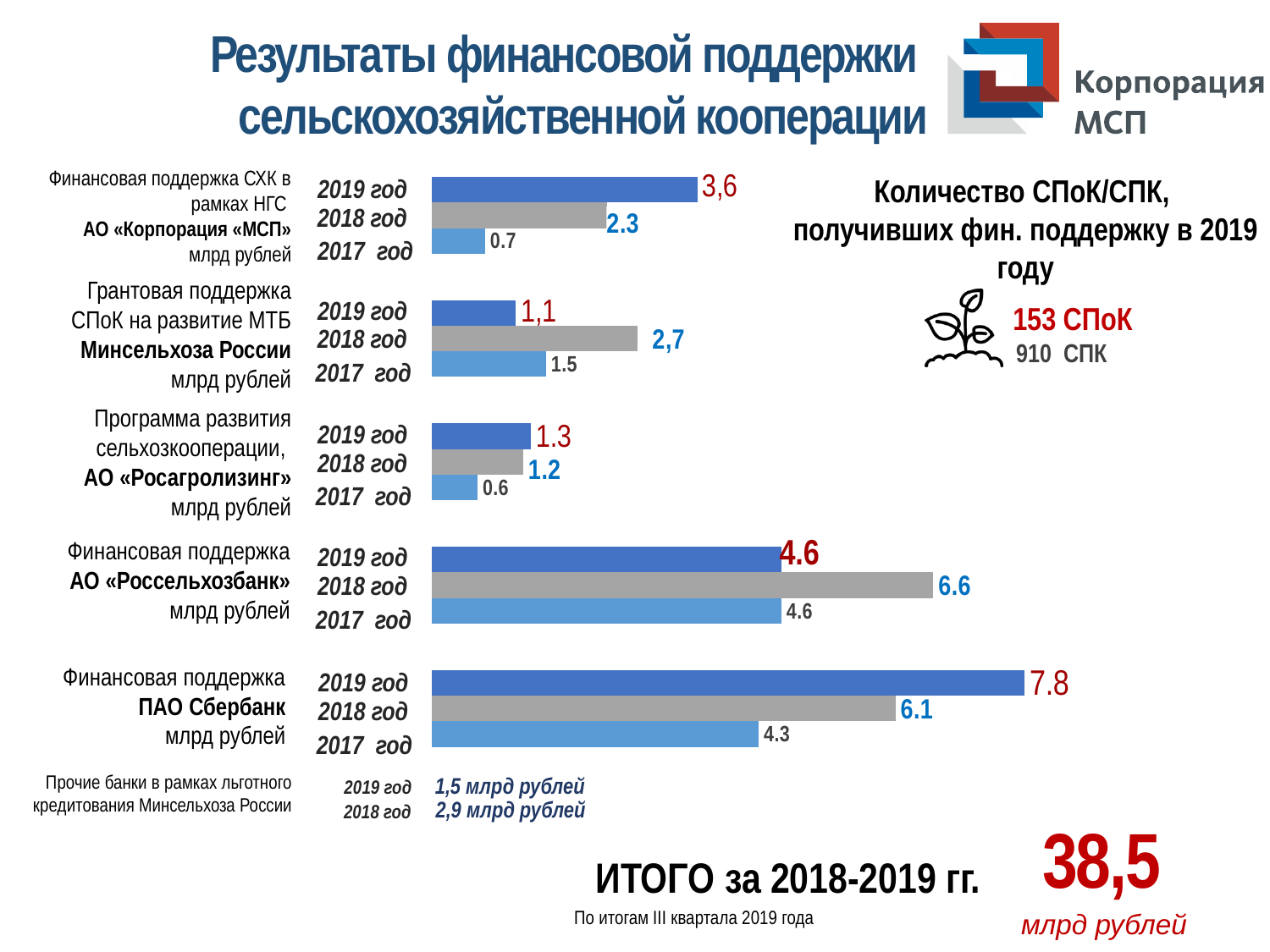
In the chart for «Финансовая поддержка СХК в рамках НГС АО «Корпорация «МСП»», what is the value for 2019 год? 3,6 In the chart for «Грантовая поддержка СПоК на развитие МТБ Минсельхоза России», which year has the highest value? 2018 год In the chart for «Финансовая поддержка АО «Россельхозбанк»», what is the difference between the 2018 and 2017 values? 2.0 What kind of chart is used for «Финансовая поддержка ПАО Сбербанк»? bar chart In the chart for «Финансовая поддержка ПАО Сбербанк», do the values rise or fall from 2017 to 2019? rise In the chart for «Программа развития сельхозкооперации АО «Росагролизинг»», what is the value for 2018 год? 1.2 In the chart for «Финансовая поддержка АО «Россельхозбанк»», what is the value for 2018 год? 6.6 In the chart for «Финансовая поддержка ПАО Сбербанк», which is larger: the value for 2019 год or for 2018 год? 2019 год In the chart for «Грантовая поддержка СПоК на развитие МТБ Минсельхоза России», what is the difference between the 2018 and 2019 values? 1,6 In the chart for «Финансовая поддержка СХК в рамках НГС АО «Корпорация «МСП»», what is the value for 2017 год? 0.7 In the chart for «Программа развития сельхозкооперации АО «Росагролизинг»», which year has the lowest value? 2017 год In the chart for «Финансовая поддержка ПАО Сбербанк», what is the difference between the 2019 and 2018 values? 1.7